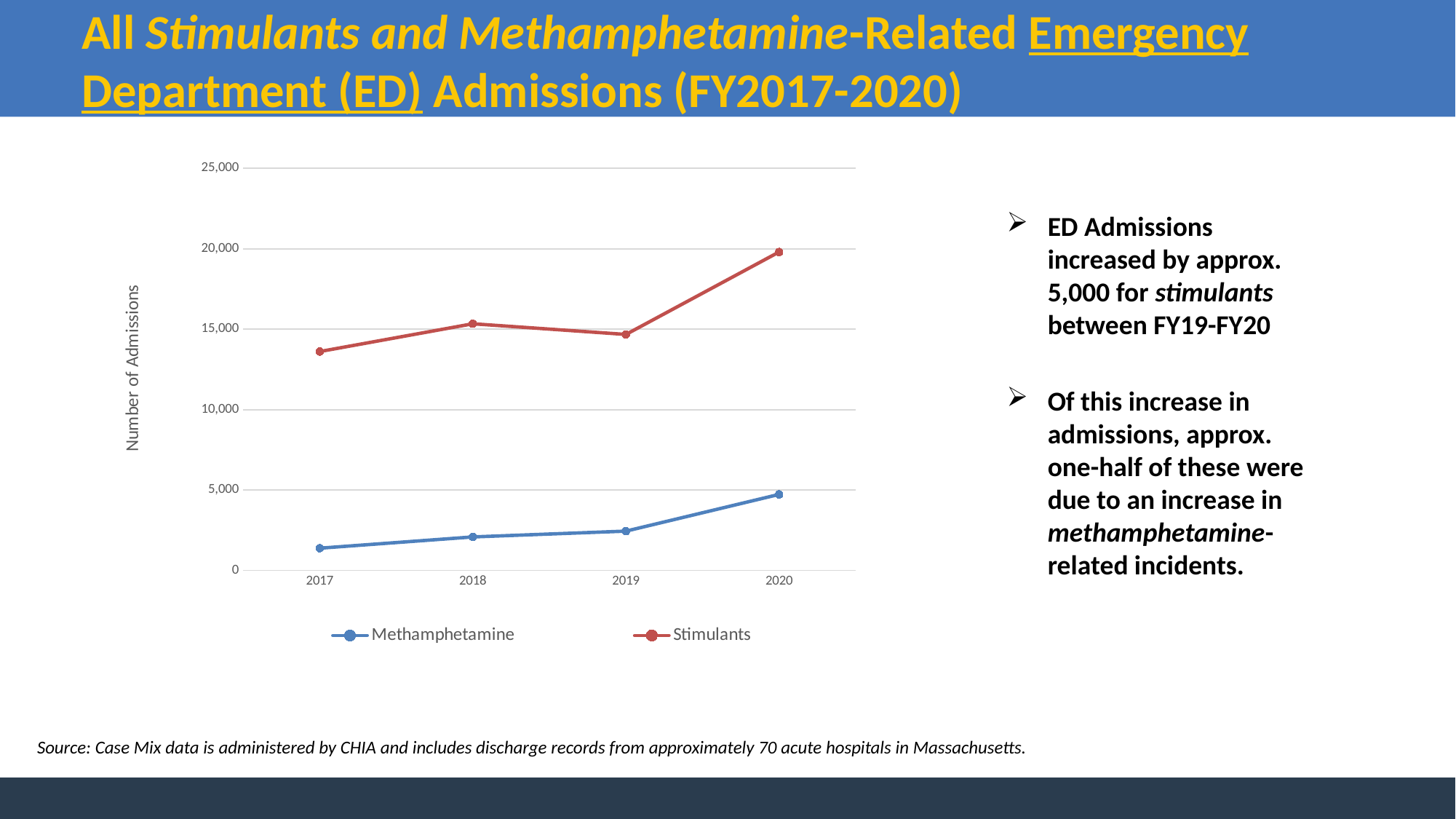
In which year is the Methamphetamine series at its lowest? 2017 How many years are plotted along the x axis? 4 In which year is the Methamphetamine series at its highest? 2020 Is the value for Stimulants in 2020 greater or less than 15,000? greater Does the Methamphetamine series rise or fall from 2017 to 2020? rise Is the value for Stimulants in 2017 greater or less than 15,000? less How many series does the legend list? 2 Which series has the larger value in 2020, Methamphetamine or Stimulants? Stimulants In which year is the Stimulants series at its highest? 2020 What kind of chart is shown on the slide? line chart What is the label on the y axis? Number of Admissions